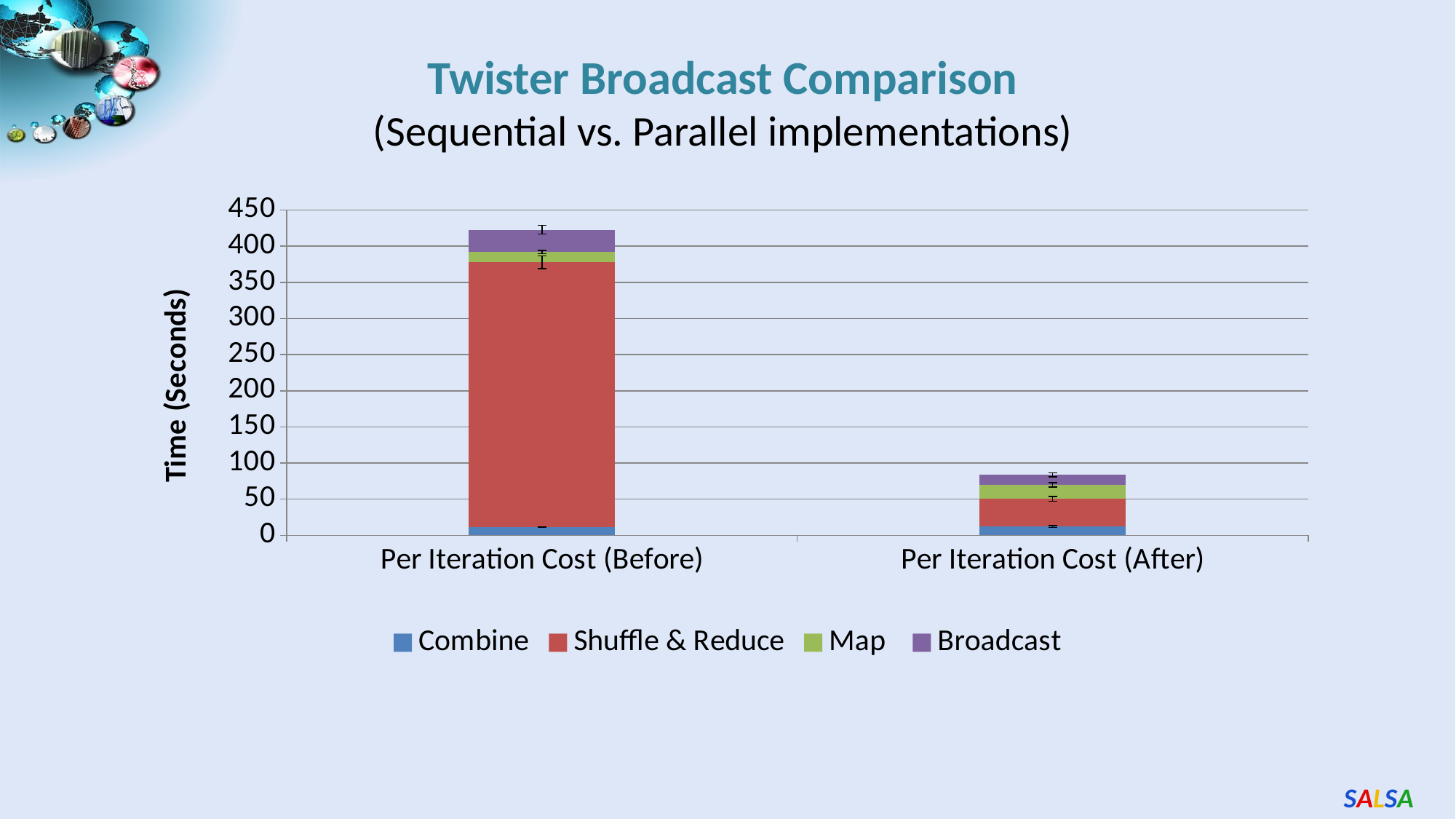
Is the Combine value for Per Iteration Cost (Before) greater or less than 50? less How many series does the legend list? 4 How many categories are shown on the x axis? 2 Is the total value for Per Iteration Cost (Before) greater or less than 400? greater Is the total value for Per Iteration Cost (After) greater or less than 100? less What is the label on the y axis of the chart? Time (Seconds) Which series makes up the largest part of the Per Iteration Cost (Before) bar? Shuffle & Reduce Which series is shown in purple in the legend? Broadcast Which category has the lowest total per iteration cost? Per Iteration Cost (After) Which category has the taller stacked bar, Per Iteration Cost (Before) or Per Iteration Cost (After)? Per Iteration Cost (Before) What kind of chart is shown on the slide? Stacked bar chart Do the total values rise or fall from Per Iteration Cost (Before) to Per Iteration Cost (After)? fall